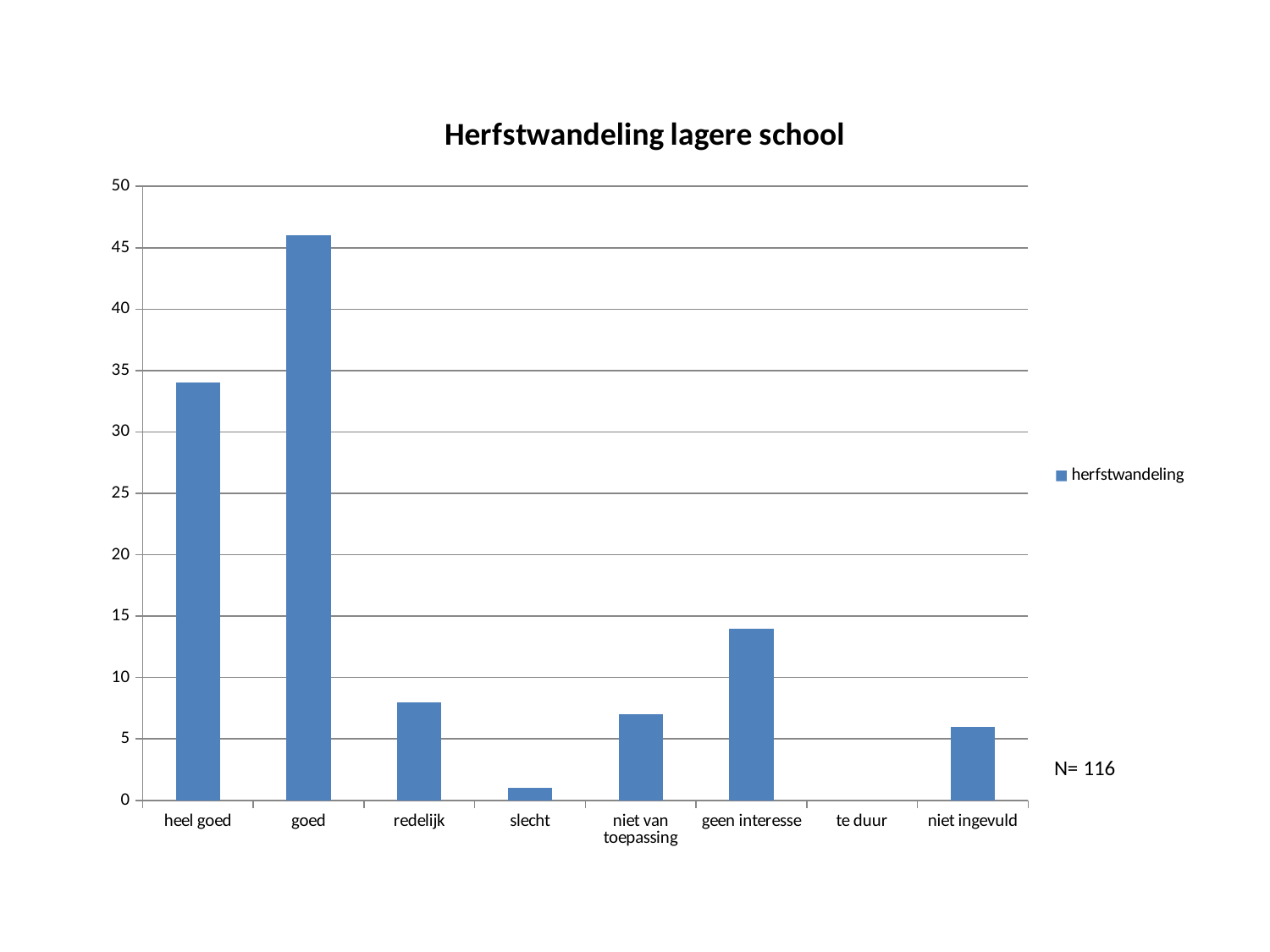
Is the value for goed greater or less than 40? greater Is the value for geen interesse greater or less than 10? greater Which is larger, the value for heel goed or the value for goed? goed Which category has the lowest value? te duur Which is larger, the value for geen interesse or the value for redelijk? geen interesse Is the value for slecht greater or less than 5? less How many categories are shown on the x axis? 8 How many series does the legend list? 1 What kind of chart is shown on the slide? bar chart Which category has the highest value? goed What is the title of the chart? Herfstwandeling lagere school